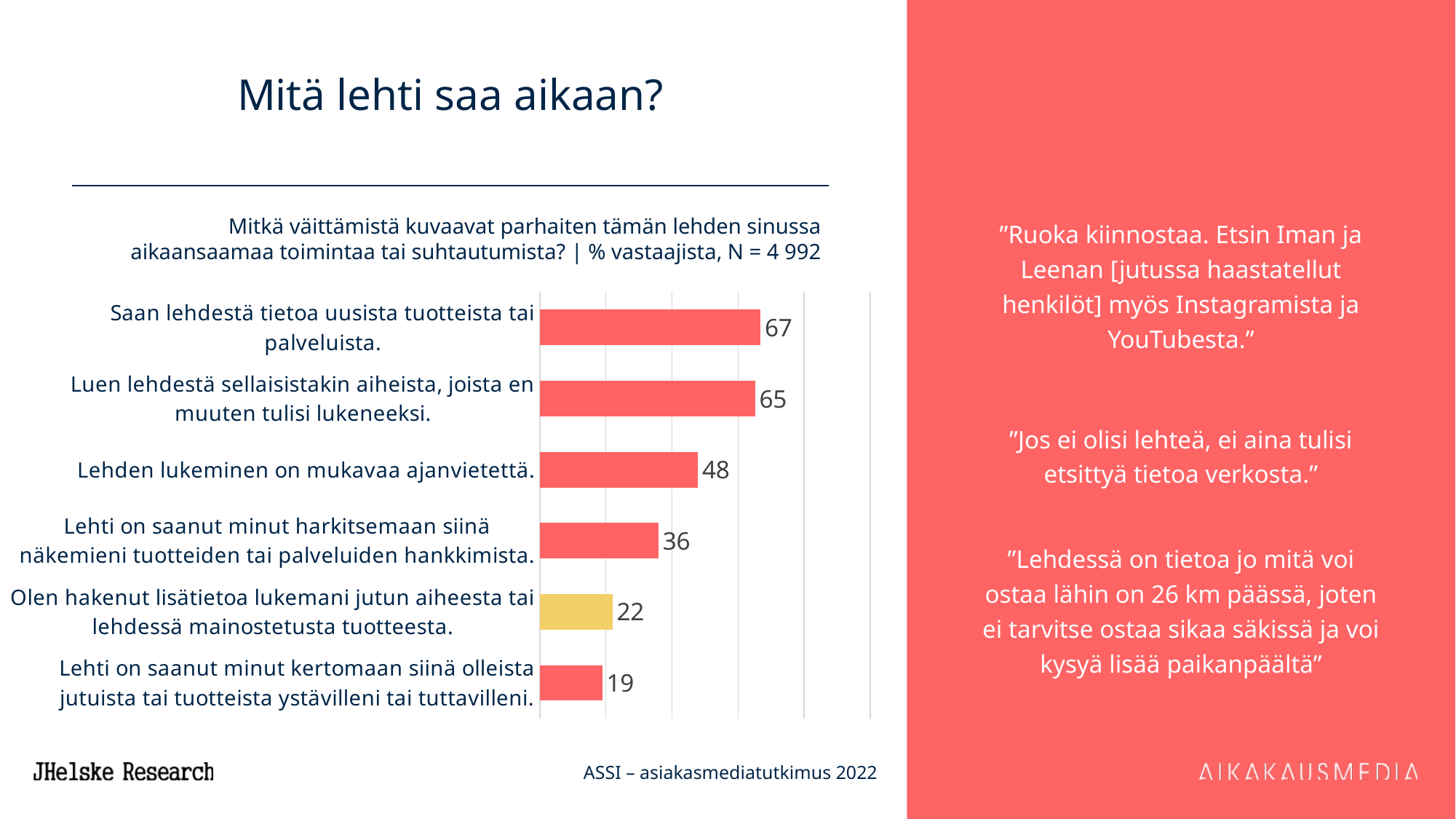
Which statement has the highest value? Saan lehdestä tietoa uusista tuotteista tai palveluista. Which is larger: the value for "Lehden lukeminen on mukavaa ajanvietettä." or the value for "Lehti on saanut minut harkitsemaan siinä näkemieni tuotteiden tai palveluiden hankkimista."? Lehden lukeminen on mukavaa ajanvietettä. What is the difference between the values for "Luen lehdestä sellaisistakin aiheista, joista en muuten tulisi lukeneeksi." and "Lehti on saanut minut harkitsemaan siinä näkemieni tuotteiden tai palveluiden hankkimista."? 29 What kind of chart is shown on the slide? Bar chart Which bar is coloured differently (yellow) from the others? Olen hakenut lisätietoa lukemani jutun aiheesta tai lehdessä mainostetusta tuotteesta. What is the N (number of respondents) stated in the chart subtitle? 4 992 What is the value for "Olen hakenut lisätietoa lukemani jutun aiheesta tai lehdessä mainostetusta tuotteesta."? 22 Which statement has the lowest value? Lehti on saanut minut kertomaan siinä olleista jutuista tai tuotteista ystävilleni tai tuttavilleni. How many statements are shown in the chart? 6 What is the value for "Saan lehdestä tietoa uusista tuotteista tai palveluista."? 67 What is the difference between the highest and lowest values in the chart? 48 What is the value for "Lehden lukeminen on mukavaa ajanvietettä."? 48